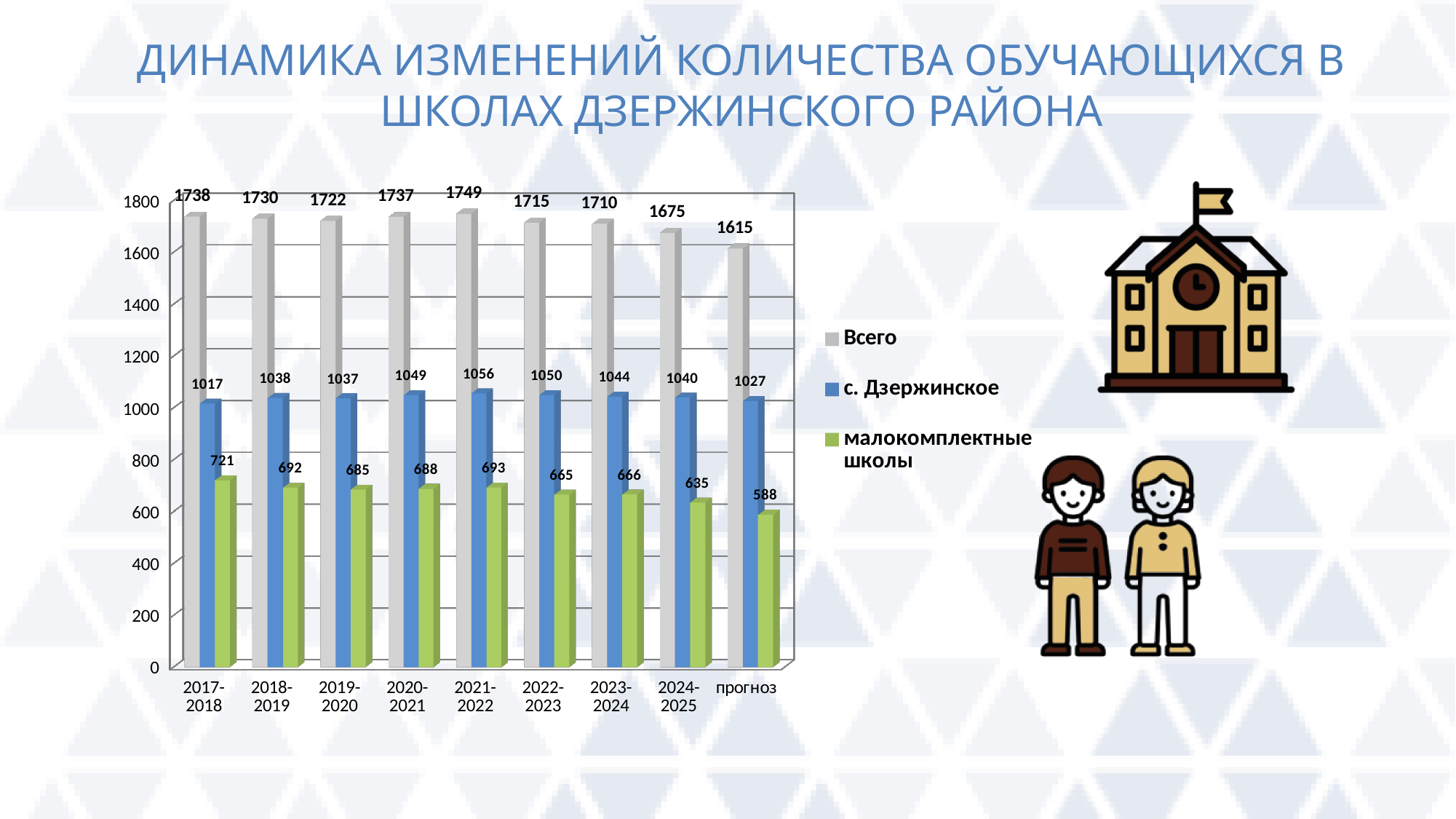
Do the values for малокомплектные школы generally rise or fall from 2017-2018 to прогноз? fall Is the value for малокомплектные школы in 2017-2018 greater or less than 600? greater What is the value for малокомплектные школы in the прогноз category? 588 In which category is the value for малокомплектные школы the lowest? прогноз What kind of chart is shown on the slide? bar chart What is the value for Всего in 2021-2022? 1749 What is the value for с. Дзержинское in 2019-2020? 1037 In which category is the value for Всего the highest? 2021-2022 How many series does the legend list? 3 What is the difference between the Всего values for 2017-2018 and прогноз? 123 Which is larger: the value for с. Дзержинское in 2018-2019 or in 2024-2025? 2018-2019 How many categories are shown on the x axis? 9